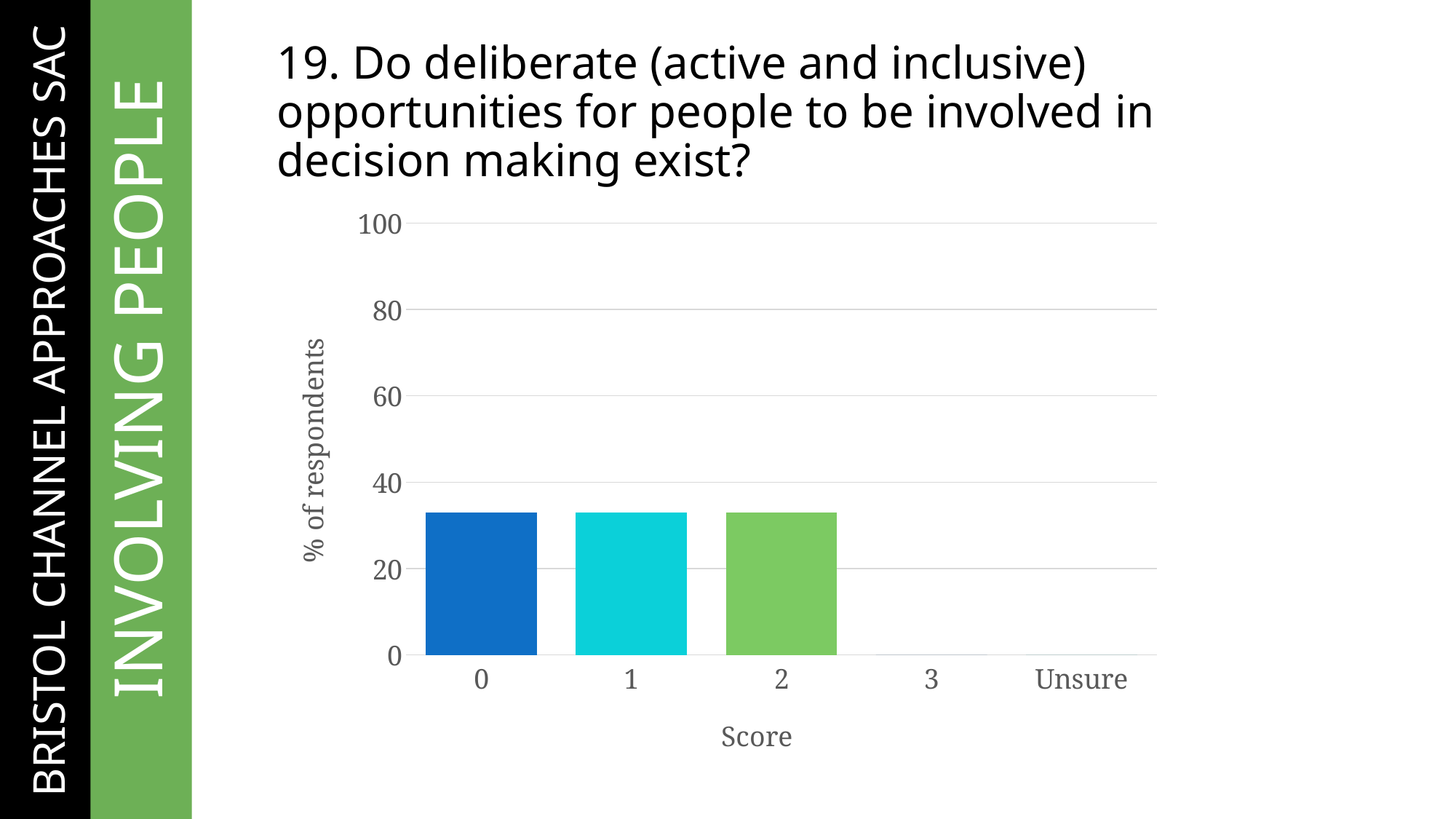
What kind of chart is shown on the slide? bar chart Which has the larger value, score 2 or Unsure? 2 Is the value for score 1 greater or less than 20? greater What is the label on the y axis of the chart? % of respondents Which has the larger value, score 0 or score 3? 0 Is the value for score 0 greater or less than 40? less Is the value for score 2 greater or less than 40? less What percentage of respondents answered Unsure? 0 How many score categories are shown on the x axis of the chart? 5 What is the label on the x axis of the chart? Score What percentage of respondents gave a score of 3? 0